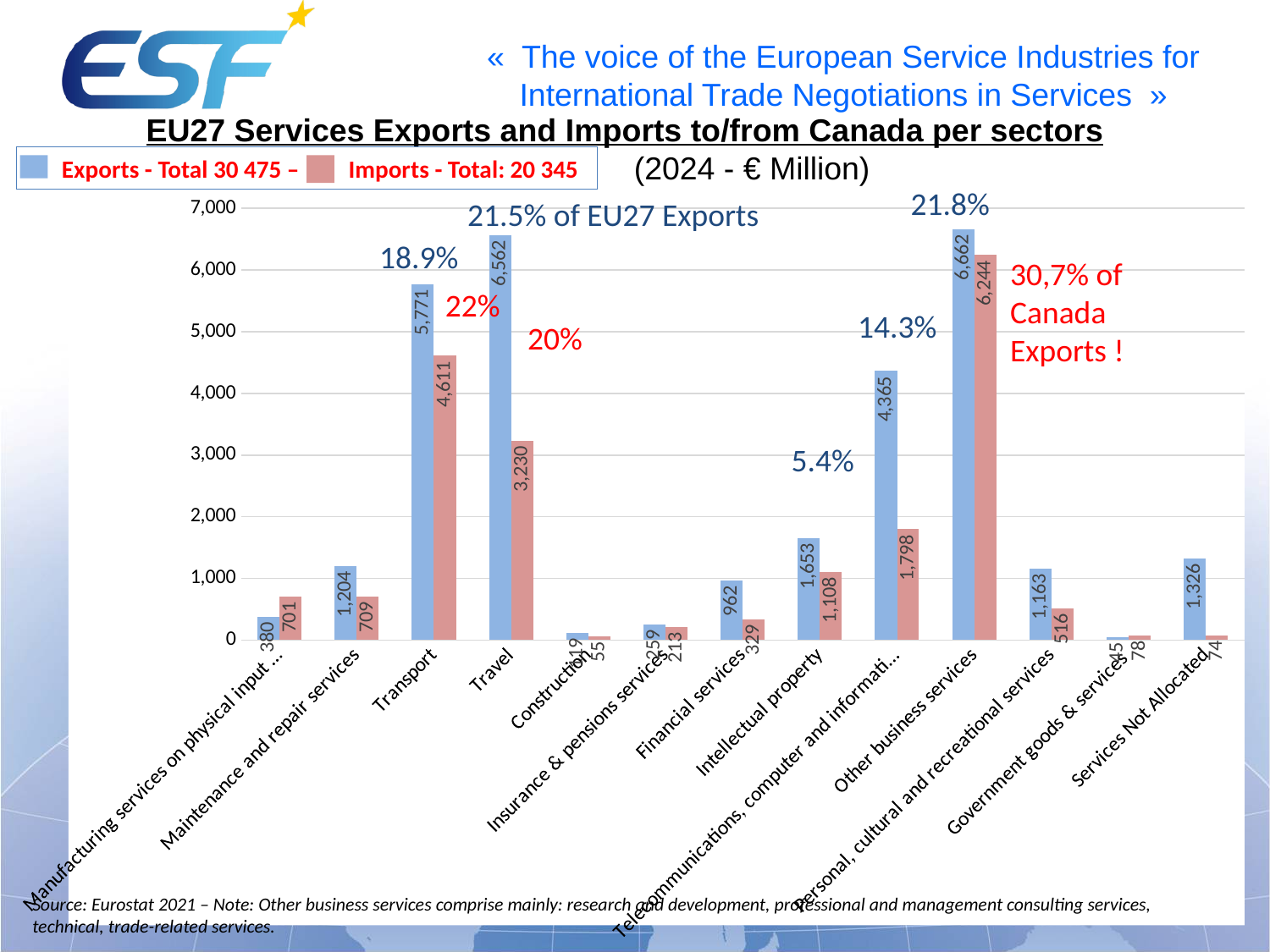
How many sector categories are plotted on the x axis? 13 How many series does the legend list? 2 Which is larger: Exports for Maintenance and repair services or Exports for Services Not Allocated? Services Not Allocated Which sector has the highest Exports value? Other business services According to the legend, what is the total of Exports? 30 475 What kind of chart is shown on the slide? bar chart What is the value of Imports for Transport? 4,611 What is the value of Exports for Travel? 6,562 Which sector has the lowest Imports value? Construction What is the difference between Exports and Imports for Travel? 3,332 Is the Imports value for Telecommunications, computer and information services greater or less than 2,000? less What is the value of Exports for Telecommunications, computer and information services? 4,365